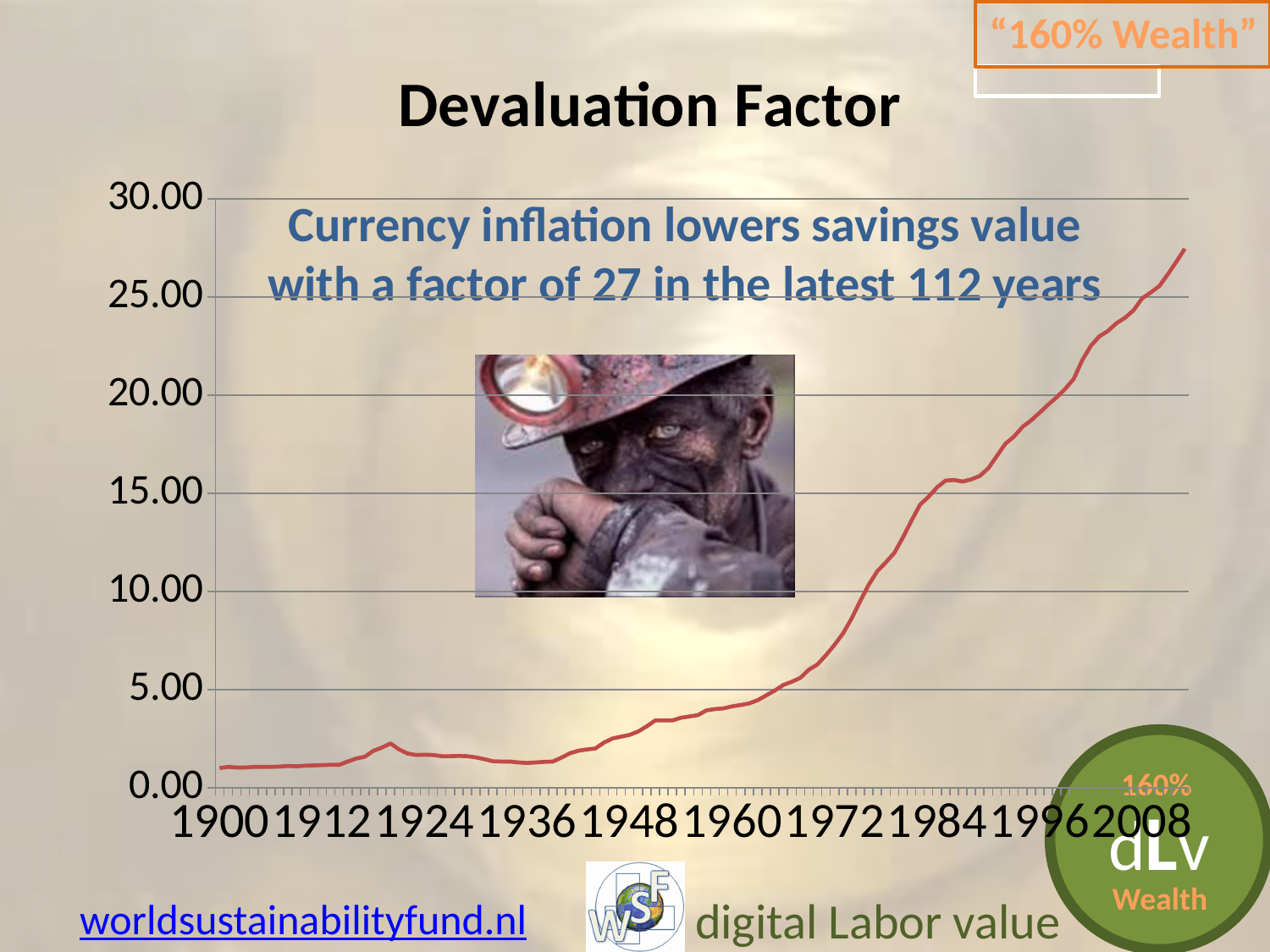
Is the value for 2008 greater or less than 20.00? greater Is the value for 1960 greater or less than 5.00? less Is the value for 1984 greater or less than 10.00? greater What kind of chart is shown on the slide? line chart Is the value higher at the end of the period (2008) or at the start (1900)? 2008 What is the title of the chart? Devaluation Factor How many year labels are shown on the x axis? 10 Does the plotted line generally rise or fall from 1900 to 2008? rise